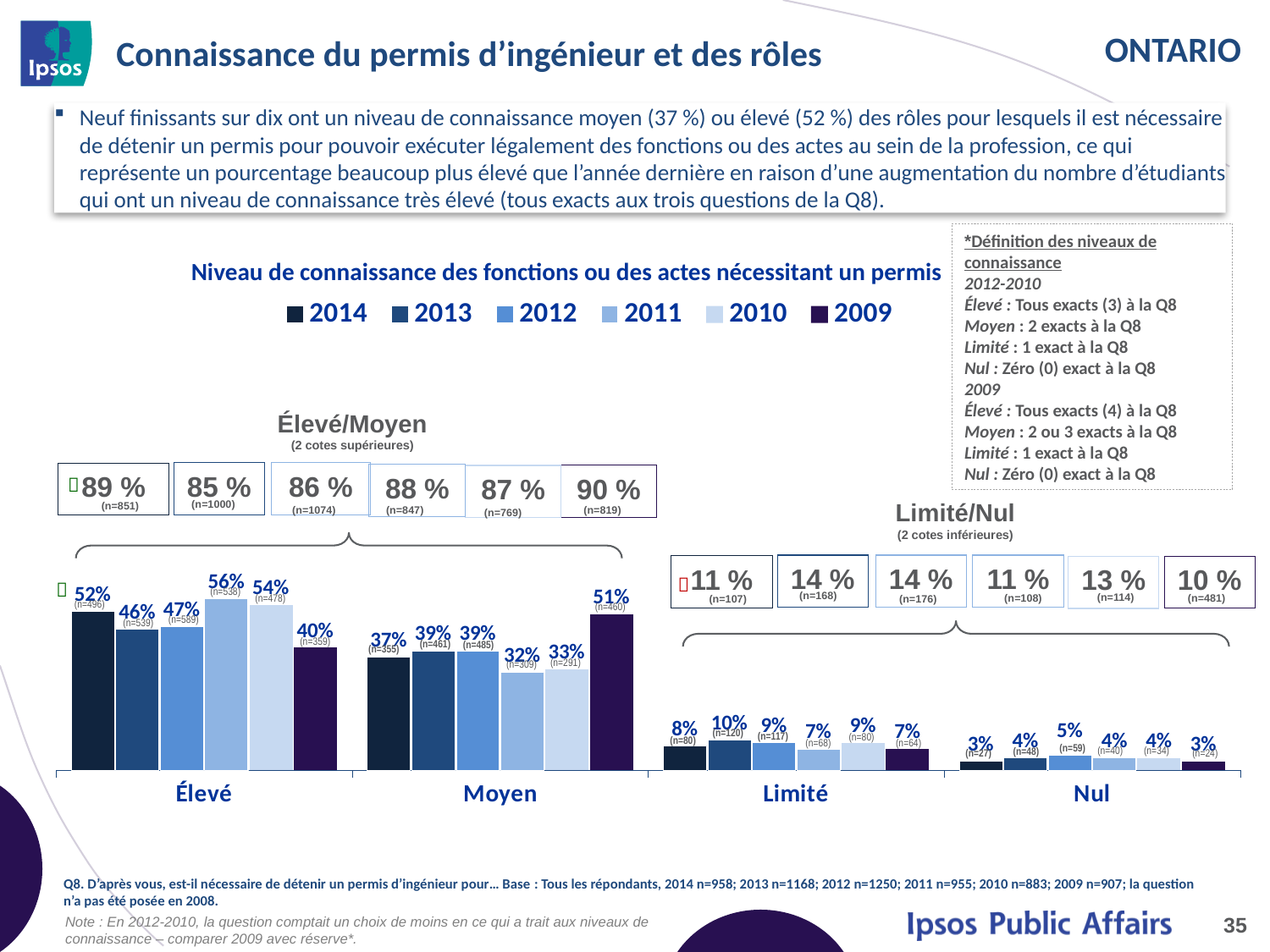
Which year has the lowest value in the Moyen category? 2011 What is the title of the chart? Niveau de connaissance des fonctions ou des actes nécessitant un permis Which year has the highest value in the Élevé category? 2011 What is the value for 2013 in the Limité category? 10% How many series does the chart legend list? 6 Which is larger in the Moyen category: the value for 2014 or the value for 2009? 2009 What is the value for 2009 in the Moyen category? 51% What is the difference between the 2011 and 2009 values in the Élevé category? 16% What is the value for 2014 in the Élevé category? 52% What kind of chart is shown on the slide? Bar chart What is the value for 2012 in the Nul category? 5% How many categories are shown on the x axis of the chart? 4